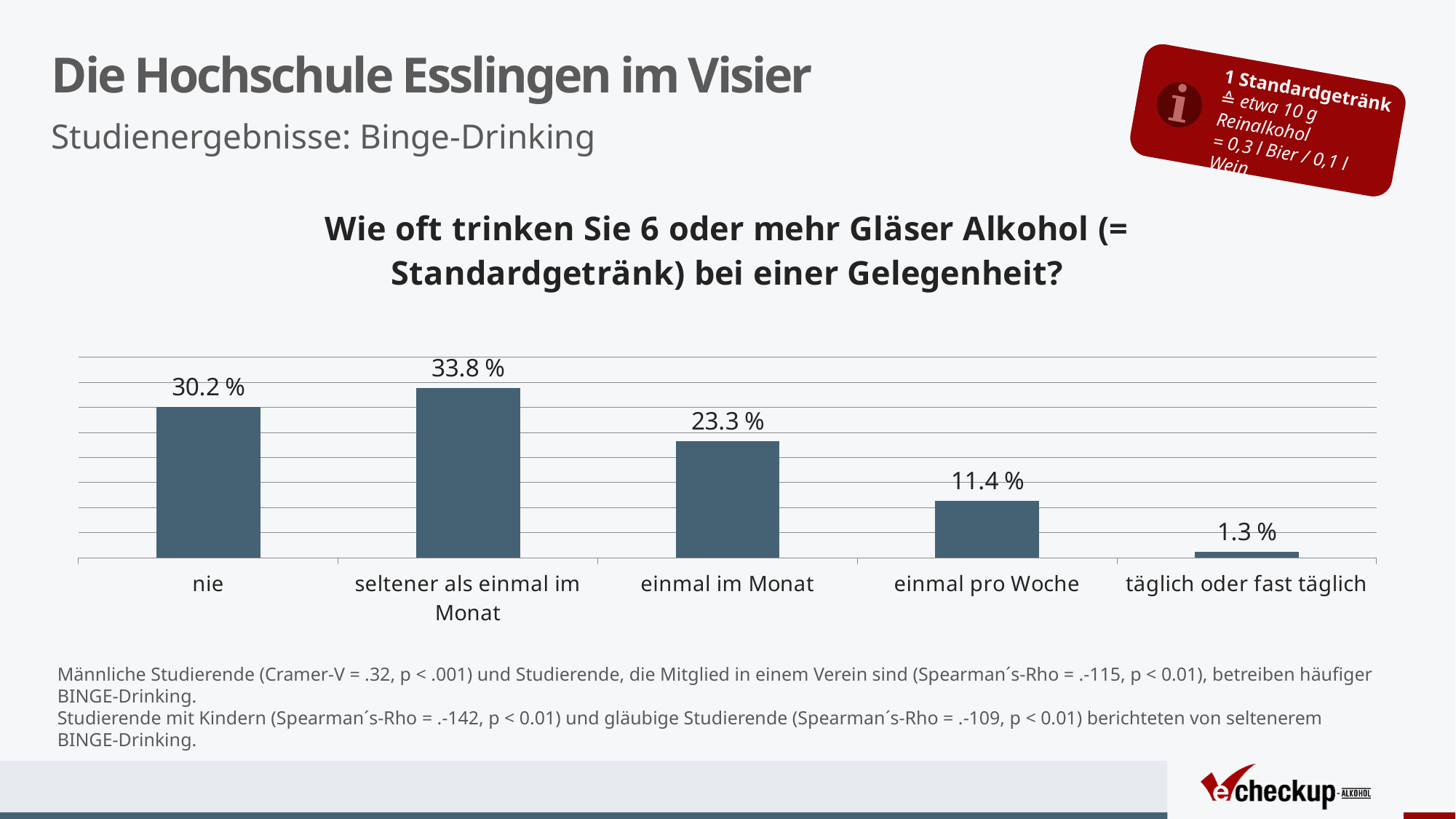
Which is larger, the value for "einmal im Monat" or the value for "einmal pro Woche"? einmal im Monat What is the value for "seltener als einmal im Monat"? 33.8 % What is the value for "nie"? 30.2 % Which category has the highest value? seltener als einmal im Monat How many categories are shown on the x axis? 5 What is the difference between the values for "seltener als einmal im Monat" and "nie"? 3.6 % What is the value for "einmal im Monat"? 23.3 % What is the value for "einmal pro Woche"? 11.4 % What is the value for "täglich oder fast täglich"? 1.3 % What is the title of the chart? Wie oft trinken Sie 6 oder mehr Gläser Alkohol (= Standardgetränk) bei einer Gelegenheit? Which category has the lowest value? täglich oder fast täglich What kind of chart is shown on the slide? bar chart